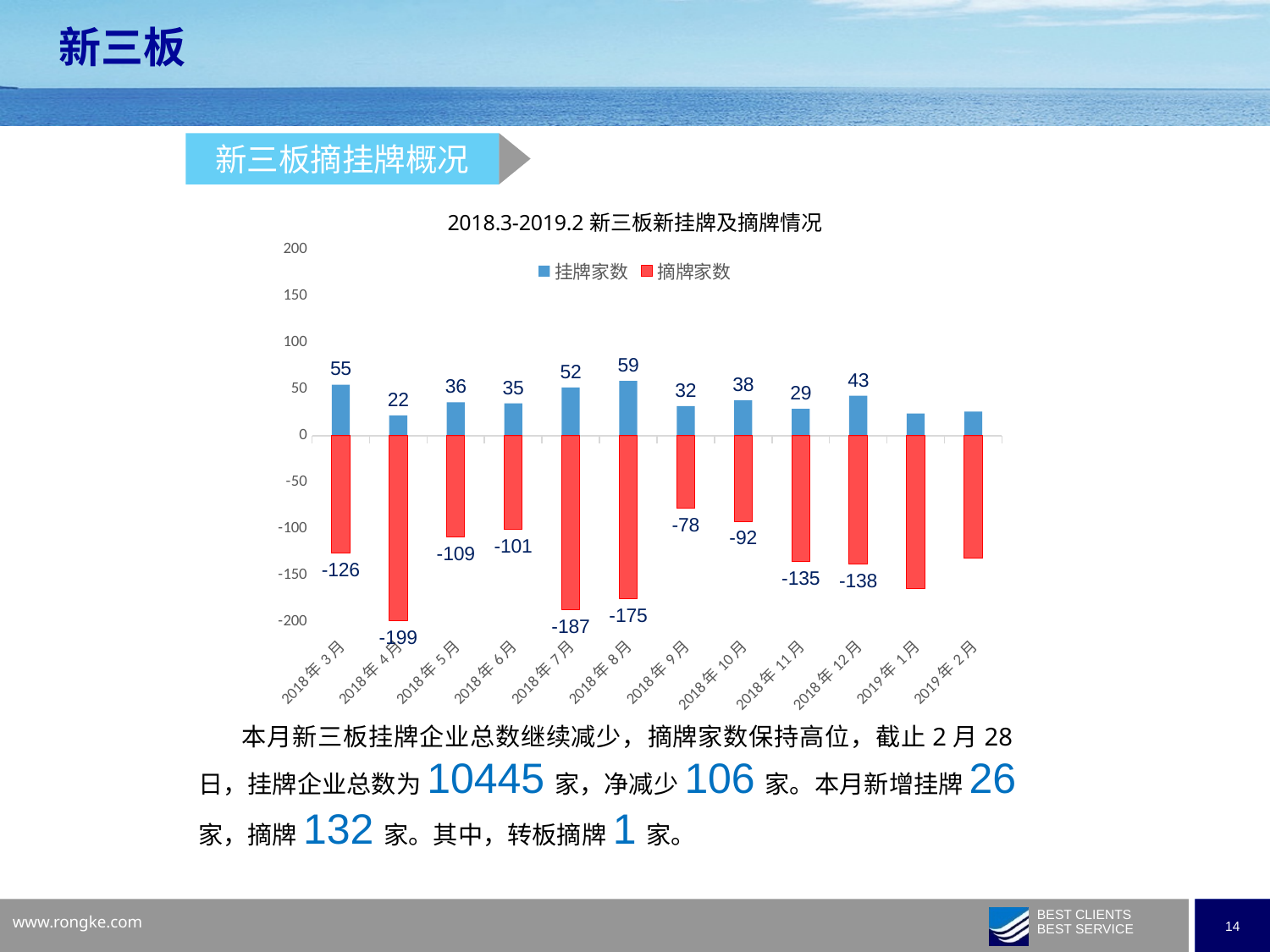
Which month has a higher 挂牌家数, 2018年7月 or 2018年12月? 2018年7月 What is the 摘牌家数 value for 2018年9月? -78 How many months are shown on the x axis of the chart? 12 Among the labeled months, which month has the highest 挂牌家数? 2018年8月 What is the 挂牌家数 value for 2018年8月? 59 Which month has the smallest number of 摘牌家数 (the shortest red bar)? 2018年9月 What is the difference between the 挂牌家数 for 2018年3月 and 2018年4月? 33 Is the 挂牌家数 value for 2019年1月 greater or less than 50? less What is the 摘牌家数 value for 2018年4月? -199 How many series does the chart legend list? 2 Which month has the largest number of 摘牌家数 (the most negative bar)? 2018年4月 What is the 挂牌家数 value for 2018年12月? 43